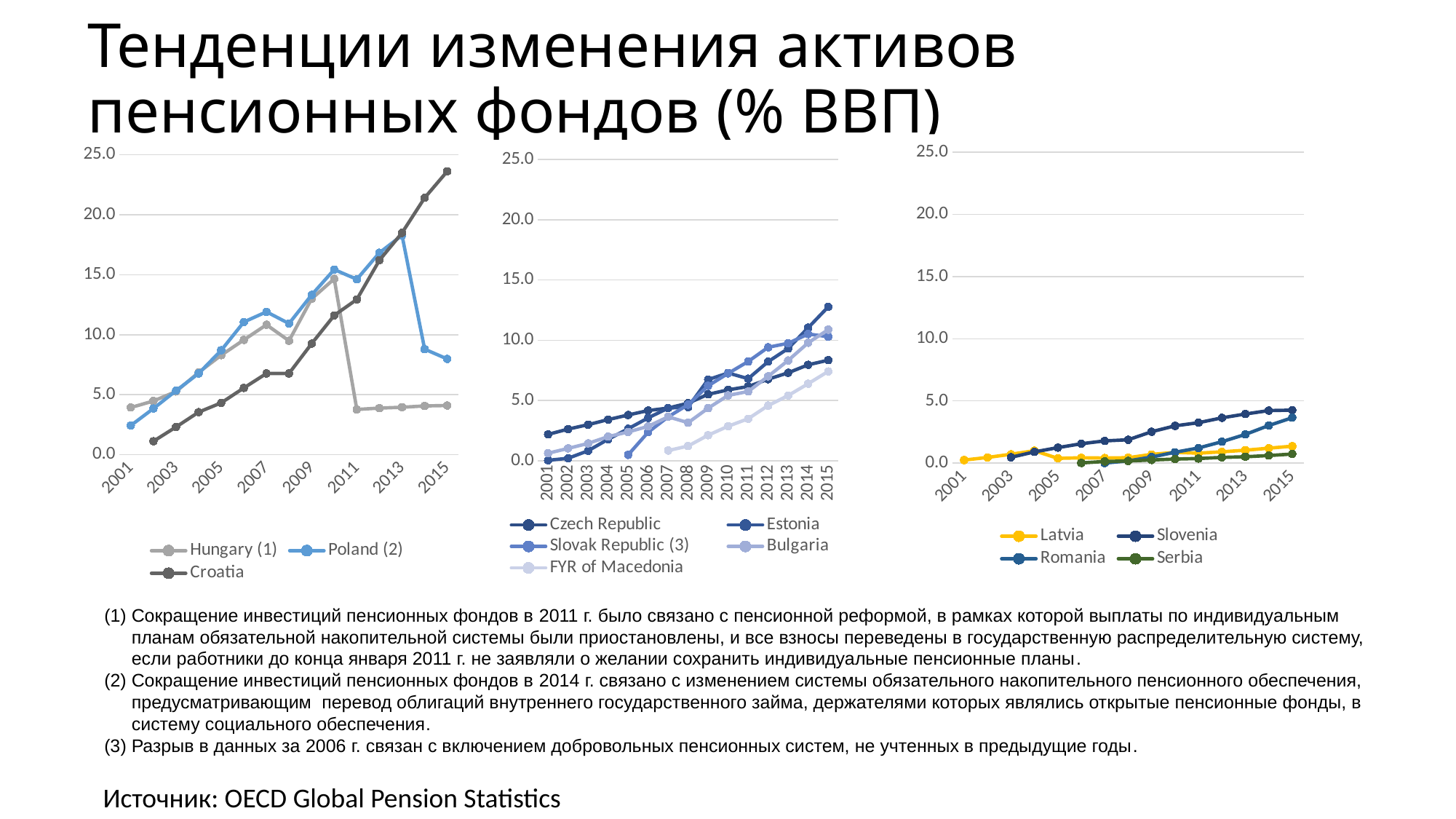
In the left chart, is the value for Hungary (1) in 2015 greater or less than 5.0? less How many series does the legend of the middle chart (Czech Republic, Estonia, etc.) list? 5 What kind of chart is the left chart (Hungary, Poland, Croatia)? line chart How many series does the legend of the right chart (Latvia, Slovenia, Romania, Serbia) list? 4 In the left chart, is the value for Croatia in 2015 greater or less than 20.0? greater In the middle chart, is the value for Estonia in 2015 greater or less than 10.0? greater In the left chart, which is larger in 2015: Croatia or Poland (2)? Croatia In the left chart, which series has the highest value in 2015? Croatia How many series does the legend of the left chart list? 3 In the right chart, which series has the highest value in 2013? Slovenia How many years are labelled on the x axis of the middle chart? 15 In the middle chart, which series has the highest value in 2015? Estonia